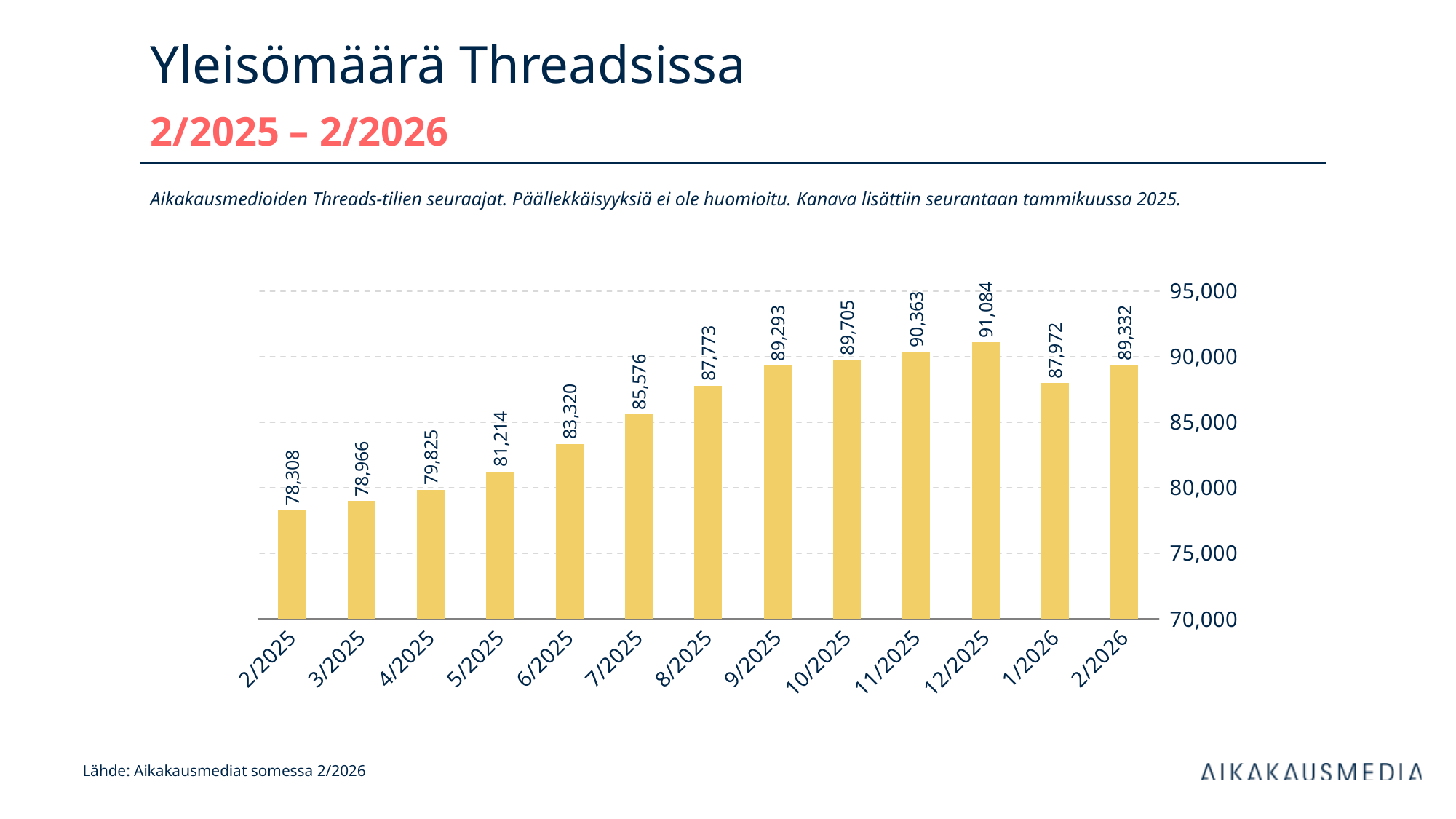
What is the value for 1/2026? 87,972 How many months are shown on the x axis? 13 What is the value for 2/2025? 78,308 What is the difference between the values for 2/2026 and 2/2025? 11,024 Do the values rise or fall from 2/2025 to 12/2025? rise Is the value for 7/2025 greater or less than 85,000? greater Which is larger, the value for 9/2025 or the value for 2/2026? 2/2026 Which month has the highest value? 12/2025 What is the value for 12/2025? 91,084 What kind of chart is shown on the slide? bar chart What is the difference between the values for 12/2025 and 1/2026? 3,112 Which month has the lowest value? 2/2025